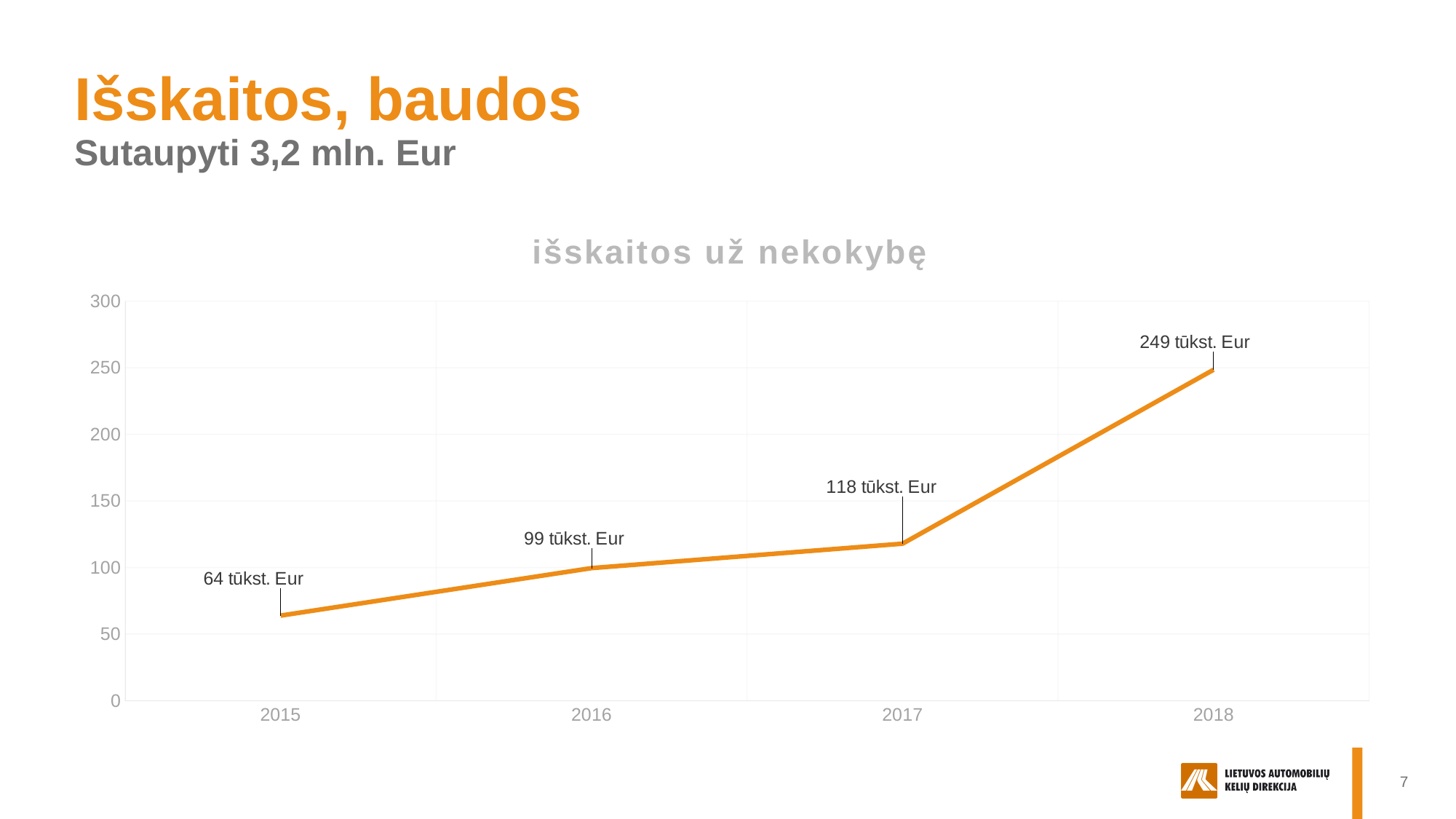
Do the values rise or fall from 2015 to 2018? rise What is the difference between the values for 2016 and 2015? 35 tūkst. Eur Which year has the highest value? 2018 What kind of chart is shown? line chart What is the value for 2016? 99 tūkst. Eur What is the value for 2015? 64 tūkst. Eur What is the difference between the values for 2018 and 2017? 131 tūkst. Eur What is the value for 2017? 118 tūkst. Eur Which is larger, the value for 2016 or the value for 2017? 2017 What is the value for 2018? 249 tūkst. Eur How many years are plotted on the chart? 4 Which year has the lowest value? 2015